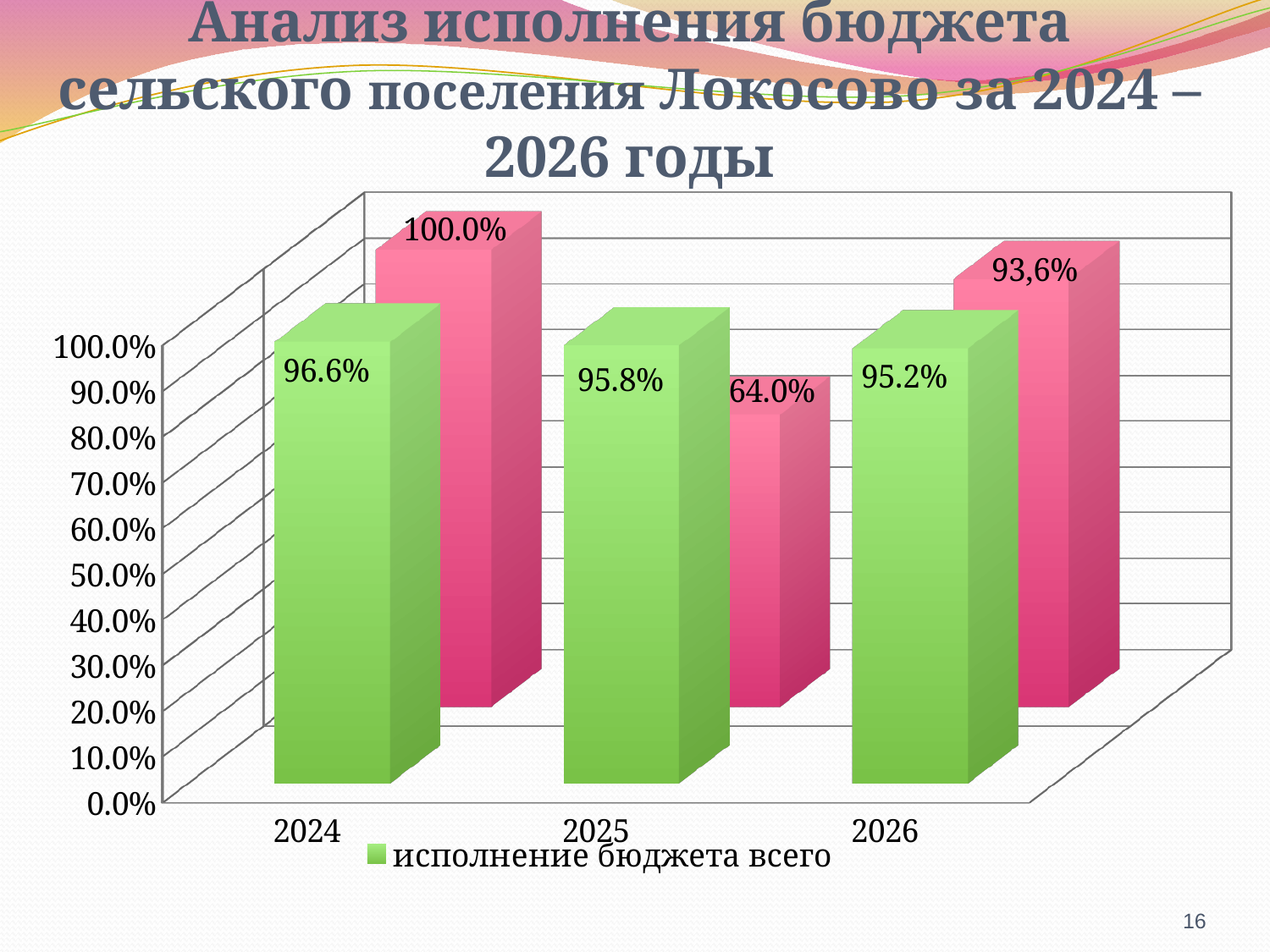
What is the value of "исполнение бюджета всего" for 2026? 95.2% What value is labelled on the pink bar for 2025? 64.0% What is the value of "исполнение бюджета всего" for 2025? 95.8% What is the difference between "исполнение бюджета всего" in 2024 and in 2026? 1.4% In which year is "исполнение бюджета всего" the highest? 2024 What is the value of "исполнение бюджета всего" for 2024? 96.6% For 2025, which bar is larger: the green "исполнение бюджета всего" bar or the pink bar? the green bar (95.8%) What value is labelled on the pink bar for 2026? 93,6% Does "исполнение бюджета всего" rise or fall from 2024 to 2026? fall How many series does the legend list? 1 What value is labelled on the pink bar for 2024? 100.0% In which year is the pink series the lowest? 2025